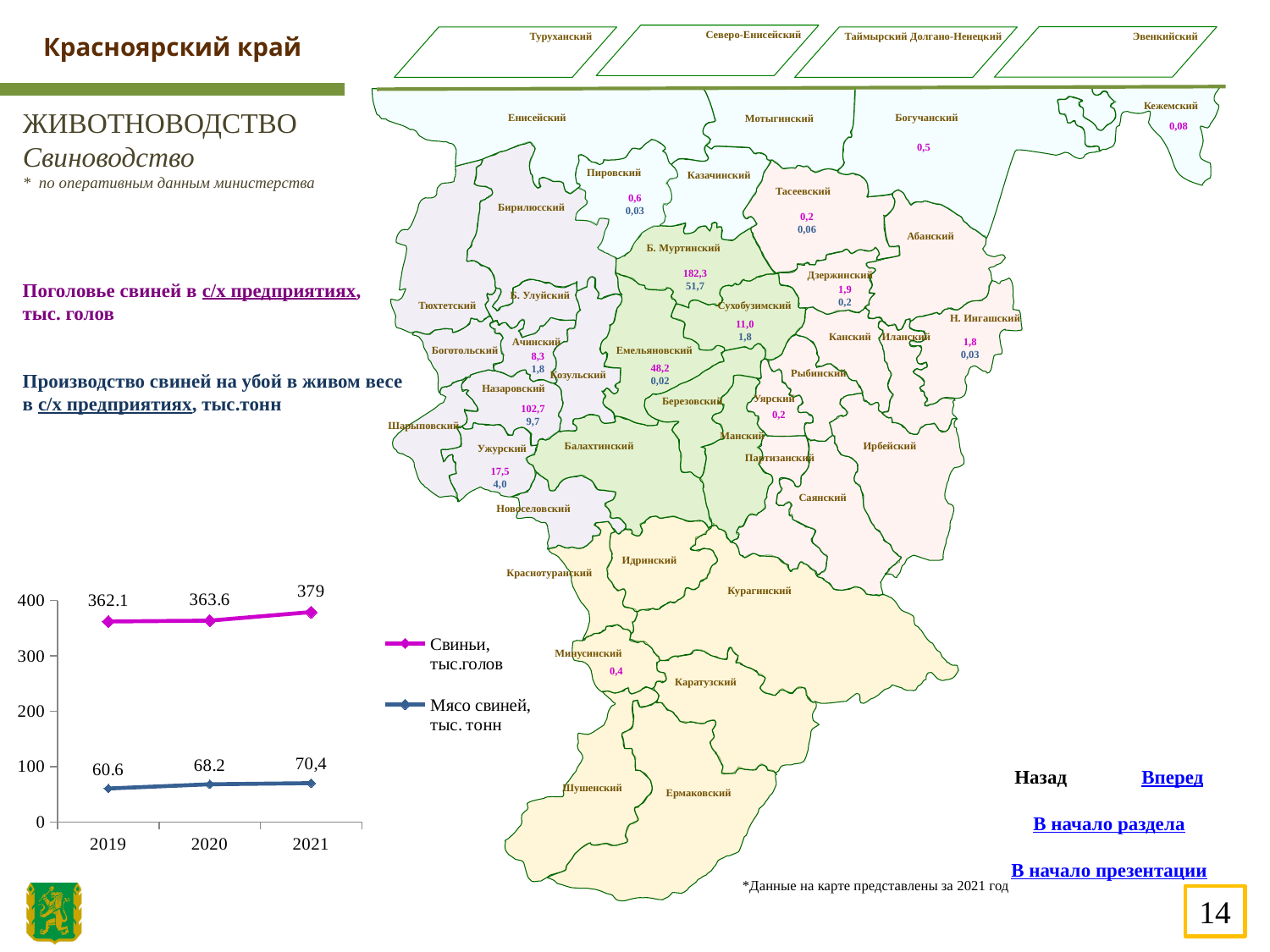
How many series does the chart legend list? 2 What kind of chart is shown on the slide? line chart What is the value for Свиньи, тыс.голов in 2019? 362.1 Do the values for Свиньи, тыс.голов rise or fall from 2019 to 2021? rise What is the value for Свиньи, тыс.голов in 2021? 379 In which year is the value for Свиньи, тыс.голов highest? 2021 What is the value for Мясо свиней, тыс. тонн in 2021? 70,4 Which is larger in 2020: the value for Свиньи, тыс.голов or the value for Мясо свиней, тыс. тонн? Свиньи, тыс.голов What is the difference between the Мясо свиней, тыс. тонн values for 2020 and 2019? 7.6 In which year is the value for Мясо свиней, тыс. тонн lowest? 2019 What is the difference between the Свиньи, тыс.голов values for 2021 and 2019? 16.9 What is the value for Мясо свиней, тыс. тонн in 2020? 68.2